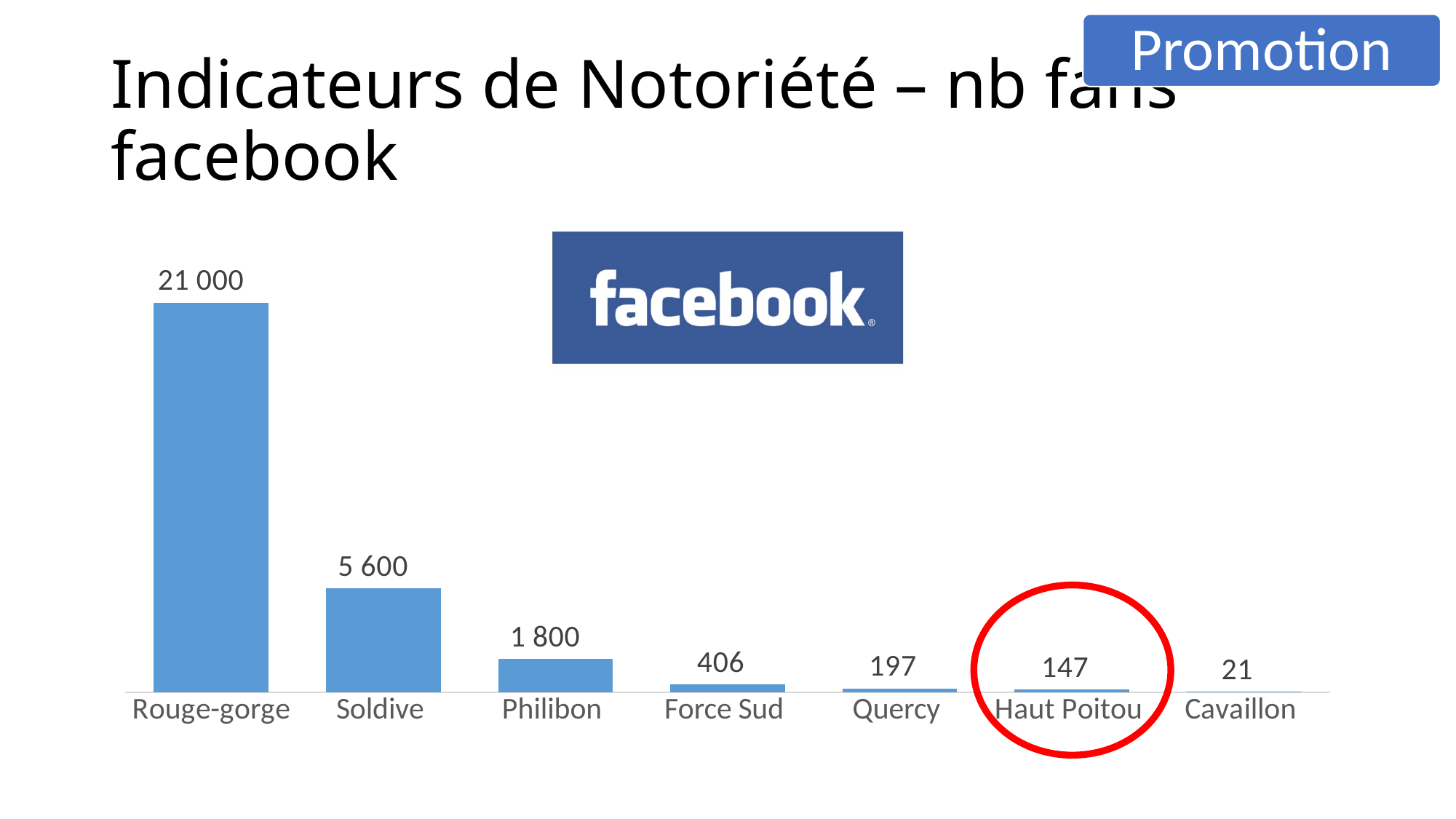
What is the difference in Facebook fans between Rouge-gorge and Soldive? 15 400 Which category is highlighted with a red circle on the chart? Haut Poitou Which has more Facebook fans, Philibon or Force Sud? Philibon How many categories are shown in the chart? 7 Which category has the lowest number of Facebook fans? Cavaillon What kind of chart is shown on the slide? Bar chart Which category has the highest number of Facebook fans? Rouge-gorge What is the difference in Facebook fans between Quercy and Haut Poitou? 50 What is the number of Facebook fans for Haut Poitou? 147 What is the number of Facebook fans for Rouge-gorge? 21 000 What is the number of Facebook fans for Force Sud? 406 What is the number of Facebook fans for Soldive? 5 600